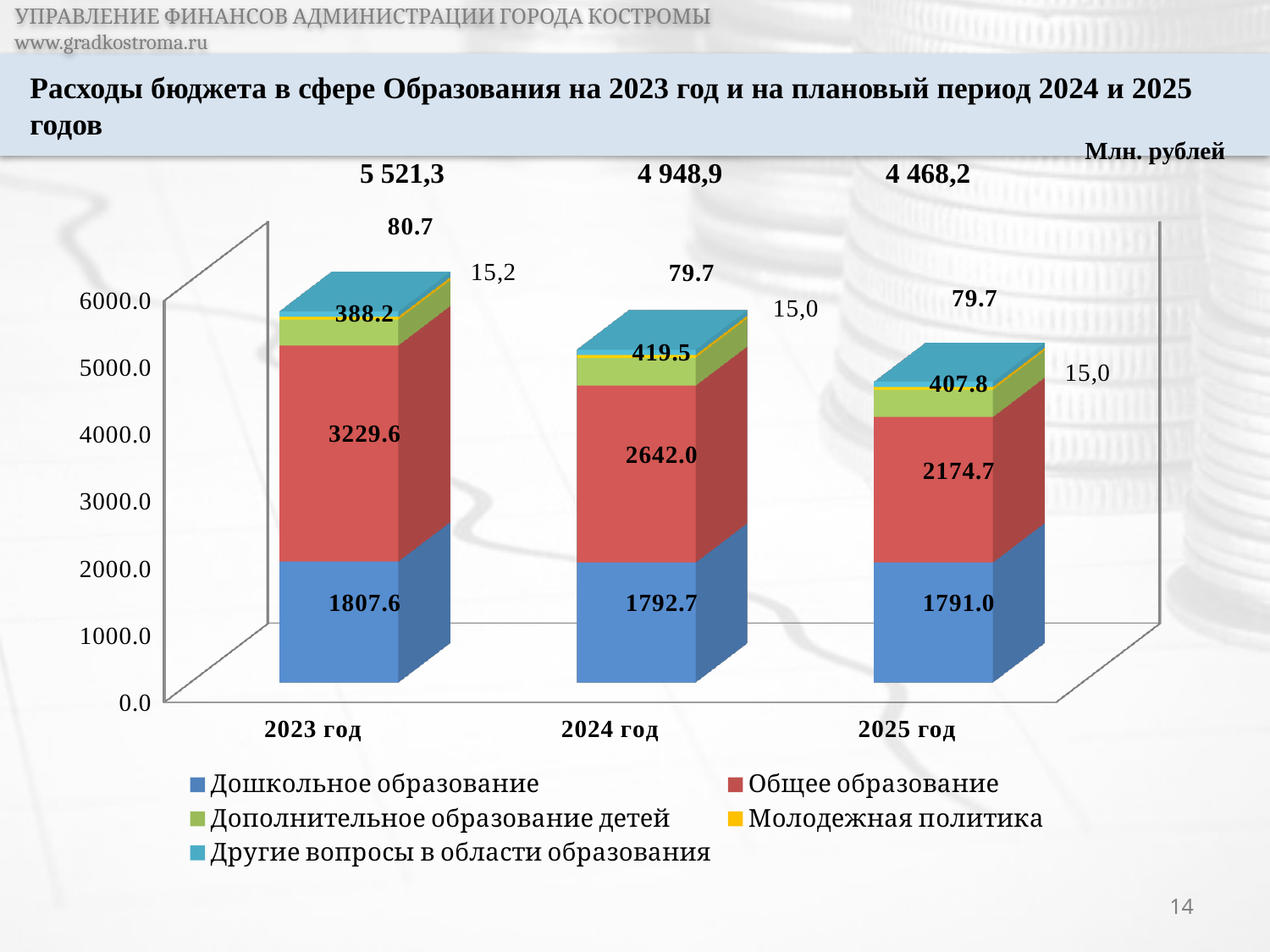
What is the total shown above the bar for 2024 год? 4 948,9 Do the total expenditures rise or fall from 2023 год to 2025 год? Fall Which year has the highest value for Общее образование? 2023 год How many years are shown on the x axis? 3 What is the value for Общее образование in 2023 год? 3229.6 What is the value for Дошкольное образование in 2025 год? 1791.0 How many series does the legend list? 5 What is the value for Дополнительное образование детей in 2024 год? 419.5 What is the difference between the Общее образование values for 2023 год and 2024 год? 587.6 Which year has the lowest total budget expenditure? 2025 год Which is larger: Дополнительное образование детей in 2024 год or in 2025 год? 2024 год What kind of chart is shown on the slide? Stacked bar chart